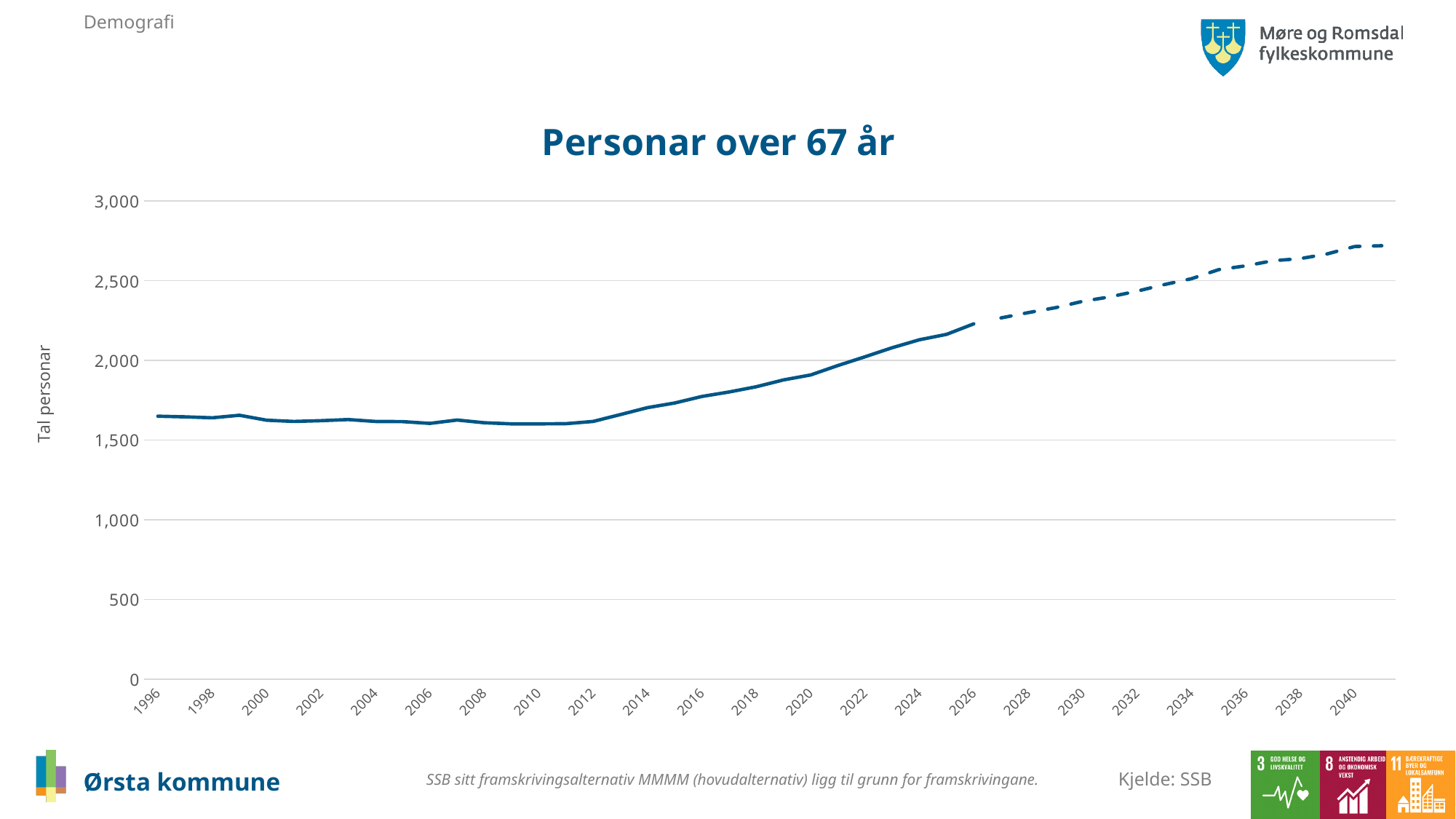
What is the label on the vertical axis of the chart? Tal personar Is the value for 1996 greater or less than 1,500? greater Is the value for 2020 greater or less than 2,000? less Do the values rise or fall along the x axis from 2012 to 2040? rise Is the value for 2010 greater or less than 2,000? less What kind of chart is shown on the slide? line chart Is the value for 2040 larger or smaller than the value for 2012? larger What is the title of the chart? Personar over 67 år